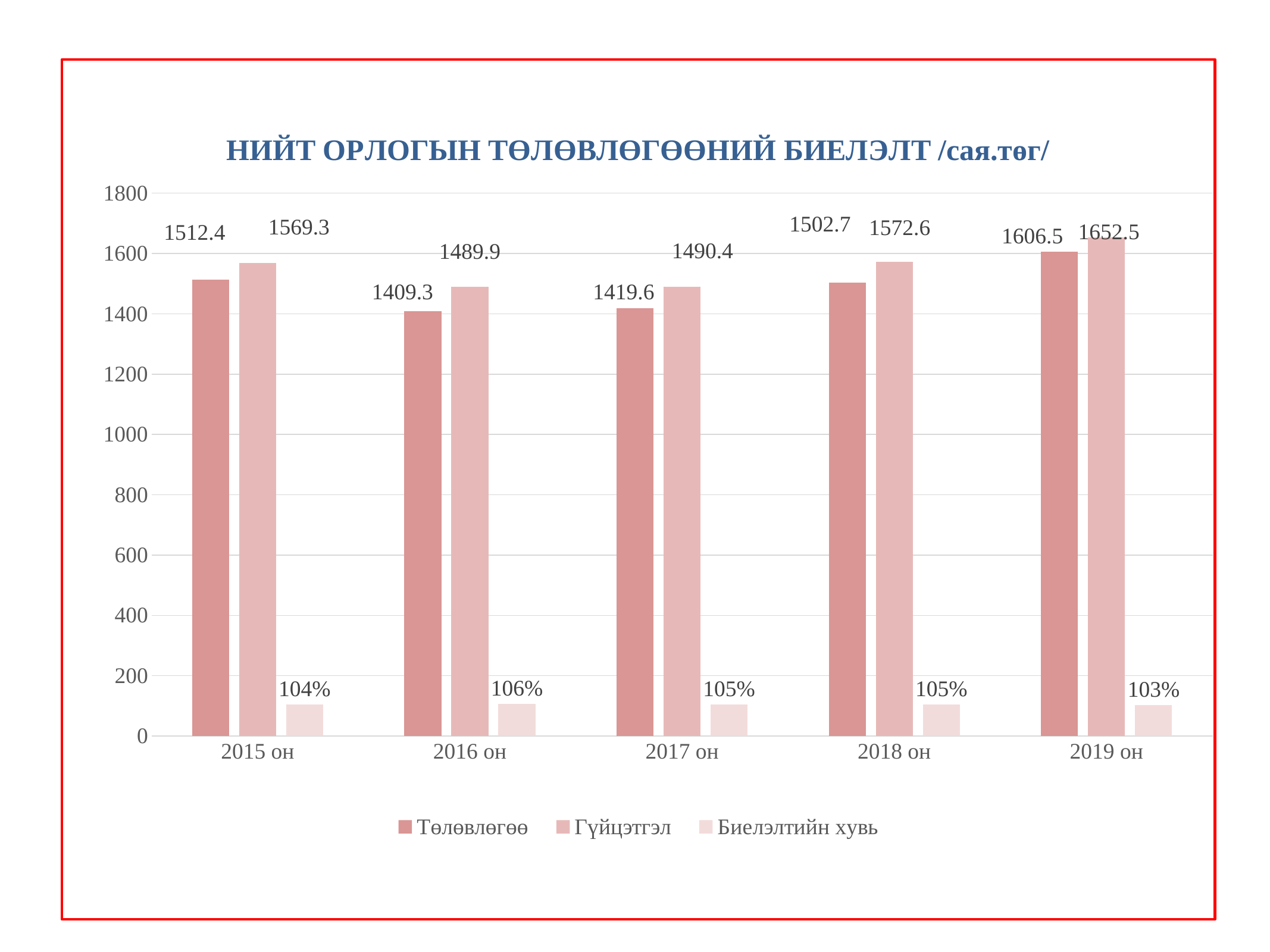
What is the Төлөвлөгөө value for 2015 он? 1512.4 Which year has the lowest Төлөвлөгөө value? 2016 он Which is larger for 2017 он: the Төлөвлөгөө value or the Гүйцэтгэл value? Гүйцэтгэл Which year has the lowest Биелэлтийн хувь value? 2019 он How many series does the legend list? 3 What is the Биелэлтийн хувь value for 2016 он? 106% What is the Гүйцэтгэл value for 2018 он? 1572.6 What kind of chart is shown on the slide? Bar chart What is the title of the chart? НИЙТ ОРЛОГЫН ТӨЛӨВЛӨГӨӨНИЙ БИЕЛЭЛТ /сая.төг/ Which year has the highest Гүйцэтгэл value? 2019 он How many years are shown on the x axis? 5 What is the difference between the Гүйцэтгэл and Төлөвлөгөө values for 2019 он? 46.0